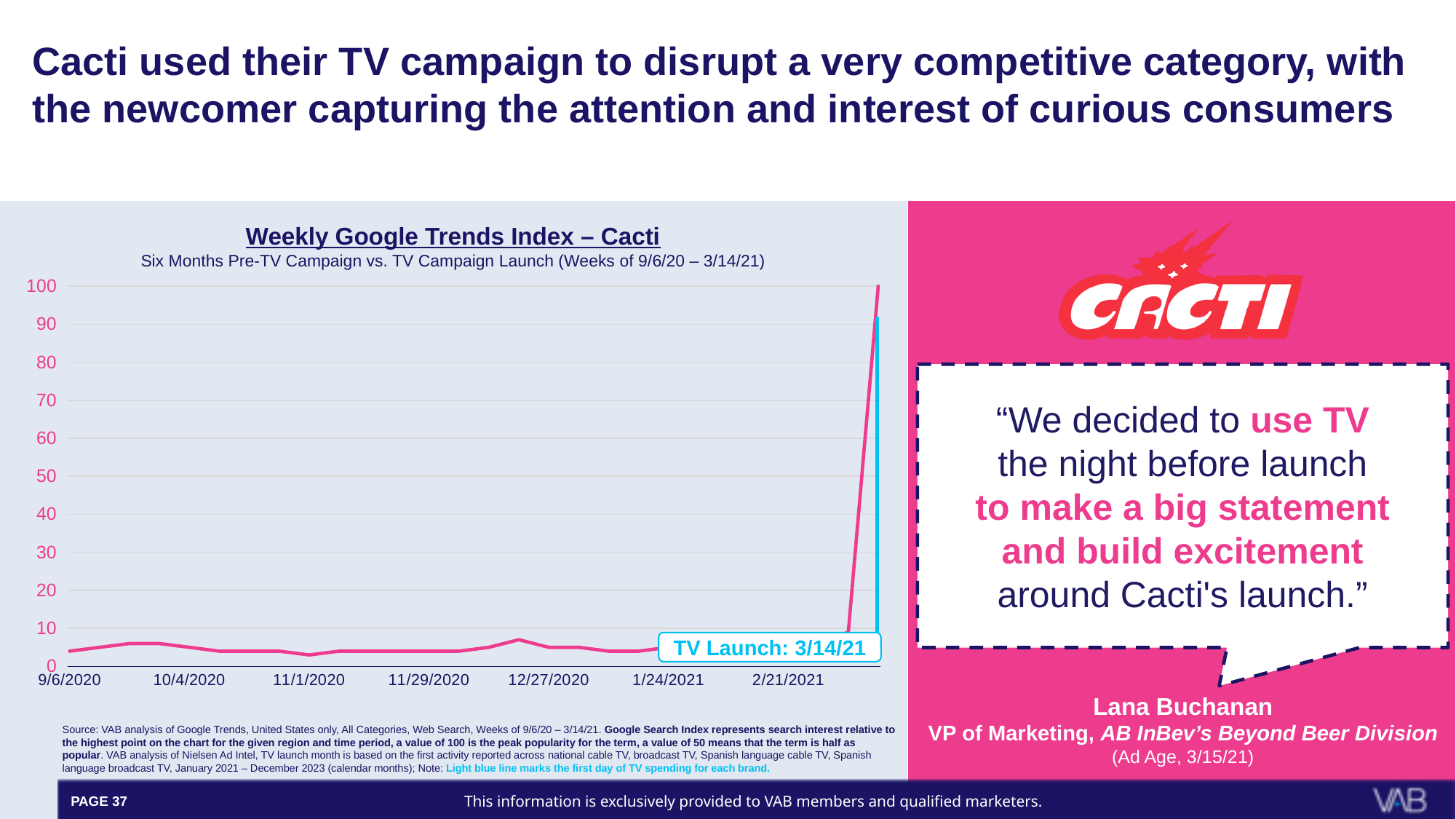
What is the title of the chart? Weekly Google Trends Index – Cacti What is the highest value the Google Trends Index line reaches on the chart? 100 What kind of chart is shown on the slide? line chart What date does the annotation on the chart give for the TV launch? 3/14/21 Is the peak value at the end of the chart greater or less than 90? greater Is the value for the week of 1/24/2021 greater or less than 10? less What is the maximum value shown on the vertical axis of the chart? 100 How many date labels are shown along the horizontal axis of the chart? 7 Which is larger: the value for the week of 11/1/2020 or the value at the final point of the chart? the final point Does the Google Trends Index rise or fall at the far right end of the chart, around the TV launch? rise Is the value for the week of 12/27/2020 greater or less than 20? less